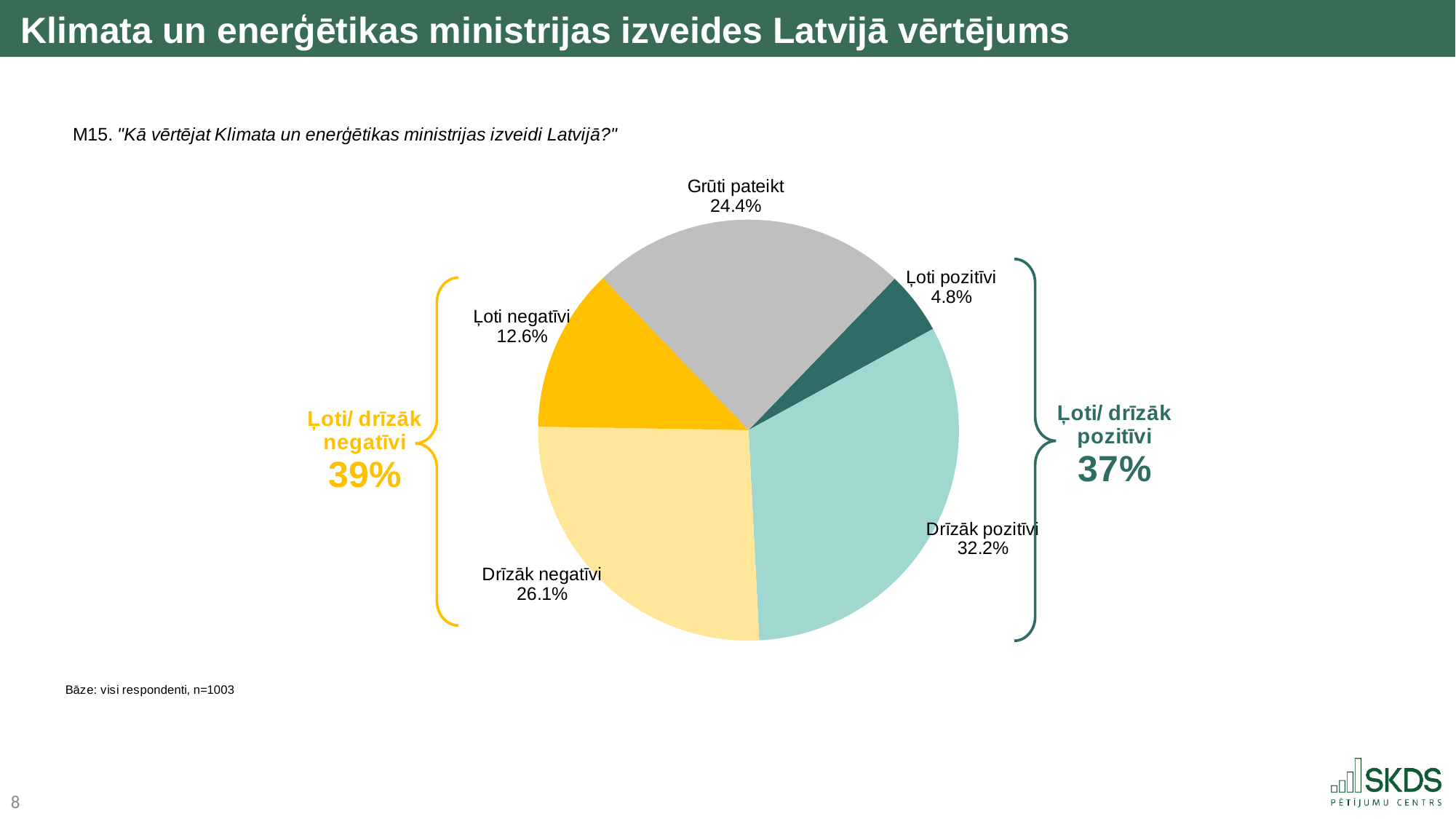
What share of respondents answered "Ļoti negatīvi"? 12.6% What is the base (number of respondents) stated below the chart? n=1003 What share of respondents answered "Drīzāk pozitīvi"? 32.2% What combined percentage is shown for "Ļoti/ drīzāk negatīvi"? 39% What is the difference between the shares for "Drīzāk pozitīvi" and "Drīzāk negatīvi"? 6.1% Which category has the largest slice of the pie? Drīzāk pozitīvi Which category has the smallest slice of the pie? Ļoti pozitīvi What kind of chart is shown on the slide? pie chart How many slices does the pie chart have? 5 What combined percentage is shown for "Ļoti/ drīzāk pozitīvi"? 37% What share of respondents answered "Grūti pateikt"? 24.4% Which is larger, the share for "Ļoti negatīvi" or the share for "Ļoti pozitīvi"? Ļoti negatīvi